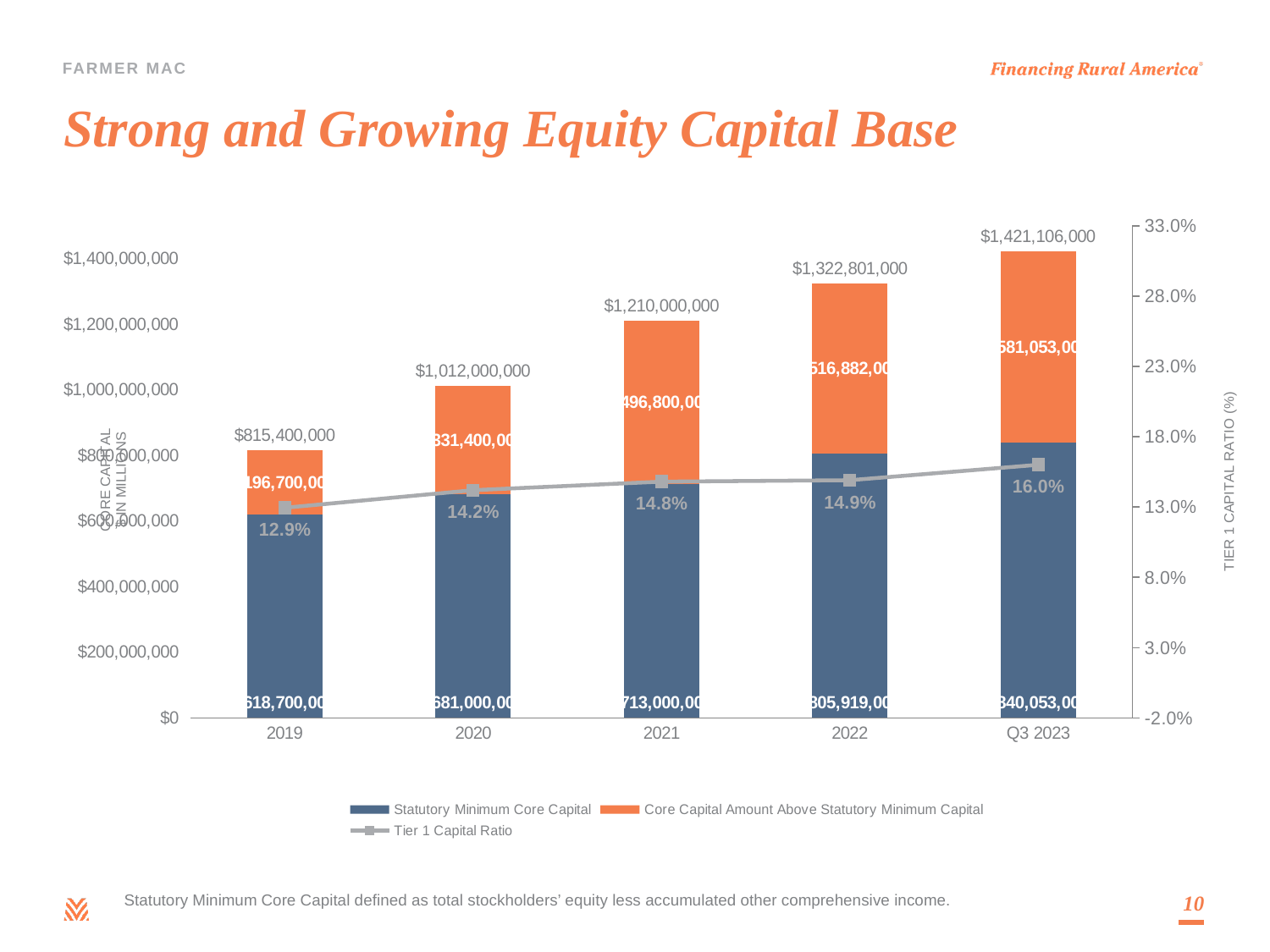
What is the Tier 1 Capital Ratio for Q3 2023? 16.0% Which period has the highest Tier 1 Capital Ratio? Q3 2023 Which period has the lowest total core capital? 2019 Is the total core capital higher in 2020 or in 2019? 2020 What is the Tier 1 Capital Ratio for 2020? 14.2% How many series does the legend list? 3 What is the total core capital shown for Q3 2023? $1,421,106,000 Does the Tier 1 Capital Ratio rise or fall from 2019 to Q3 2023? Rise What is the difference between the total core capital in Q3 2023 and in 2022? $98,305,000 How many periods are shown on the x axis? 5 By how many percentage points did the Tier 1 Capital Ratio increase from 2019 to Q3 2023? 3.1% What is the total core capital shown for 2021? $1,210,000,000